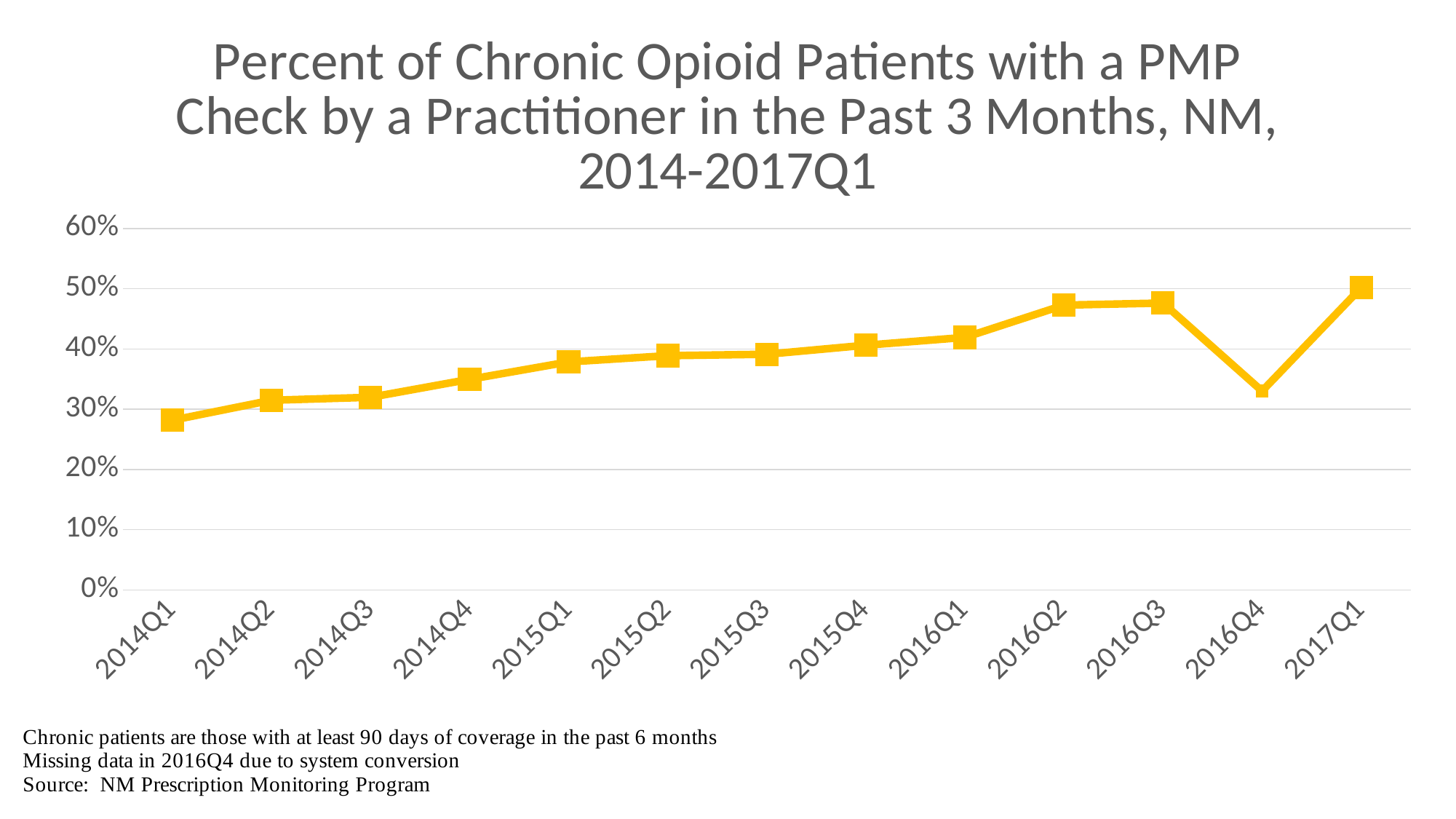
Is the value for 2014Q4 greater or less than 30%? greater How many quarters are plotted on the x axis? 13 Is the value for 2016Q2 greater or less than 40%? greater Which quarter has the larger value, 2014Q2 or 2015Q1? 2015Q1 Which quarter has the larger value, 2016Q3 or 2016Q4? 2016Q3 Which quarter has the highest percent of chronic opioid patients with a PMP check? 2017Q1 According to the note on the slide, why is data missing in 2016Q4? system conversion Is the value for 2014Q1 greater or less than 30%? less What kind of chart is shown on the slide? line chart Do the values generally rise or fall from 2014Q1 to 2016Q3? rise Which quarter has the lowest percent of chronic opioid patients with a PMP check? 2014Q1